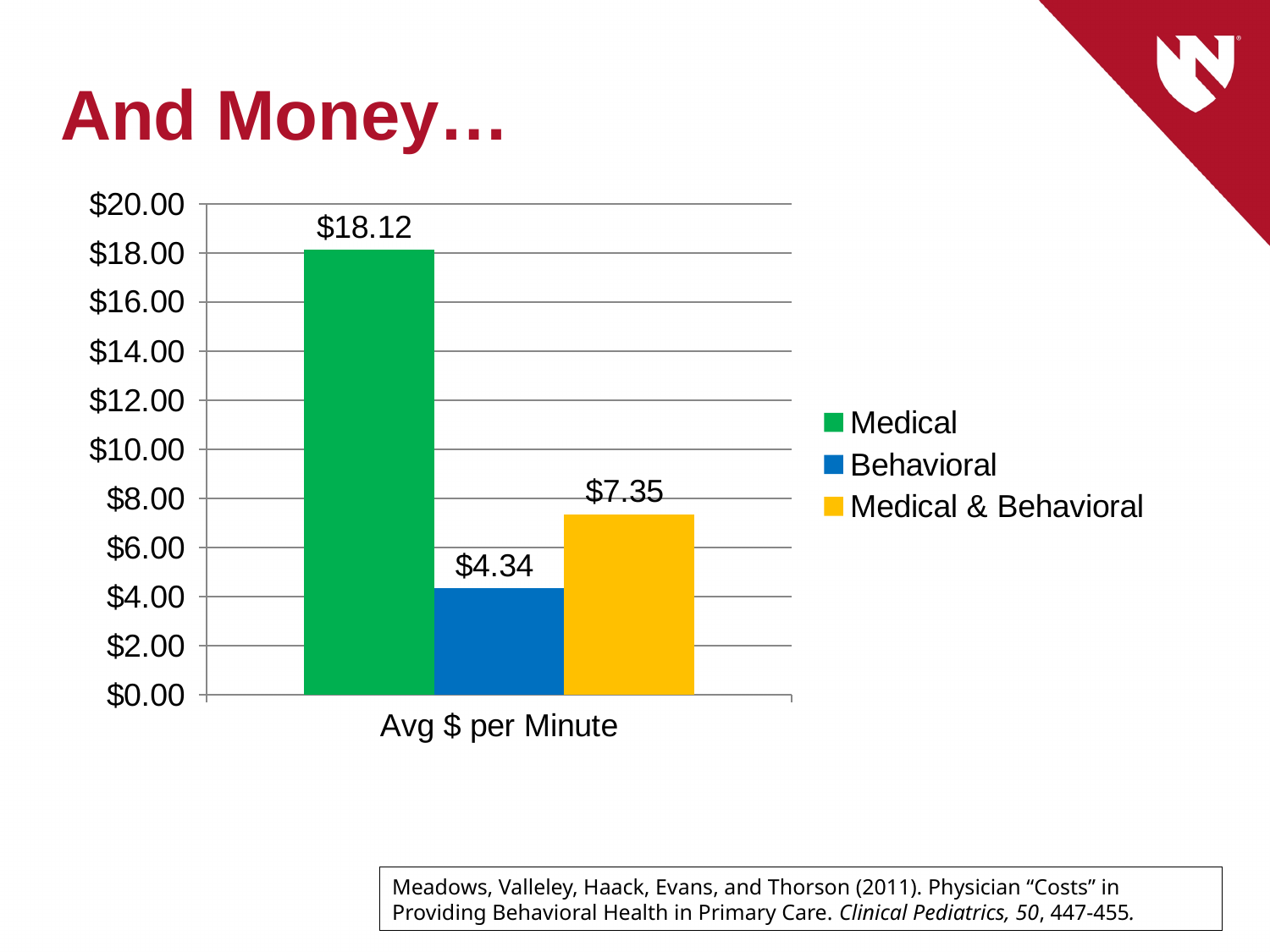
Which is larger, the value for Behavioral or the value for Medical & Behavioral? Medical & Behavioral How many series does the legend list? 3 What is the average $ per minute for Medical? $18.12 Which series has the highest average $ per minute? Medical What kind of chart is shown on the slide? Bar chart Is the value for Medical greater or less than $16.00? greater What is the difference between the Medical and Behavioral values? $13.78 What is the difference between the Medical & Behavioral and Behavioral values? $3.01 What is the label on the x axis of the chart? Avg $ per Minute What is the average $ per minute for Medical & Behavioral? $7.35 What is the average $ per minute for Behavioral? $4.34 Which series has the lowest average $ per minute? Behavioral